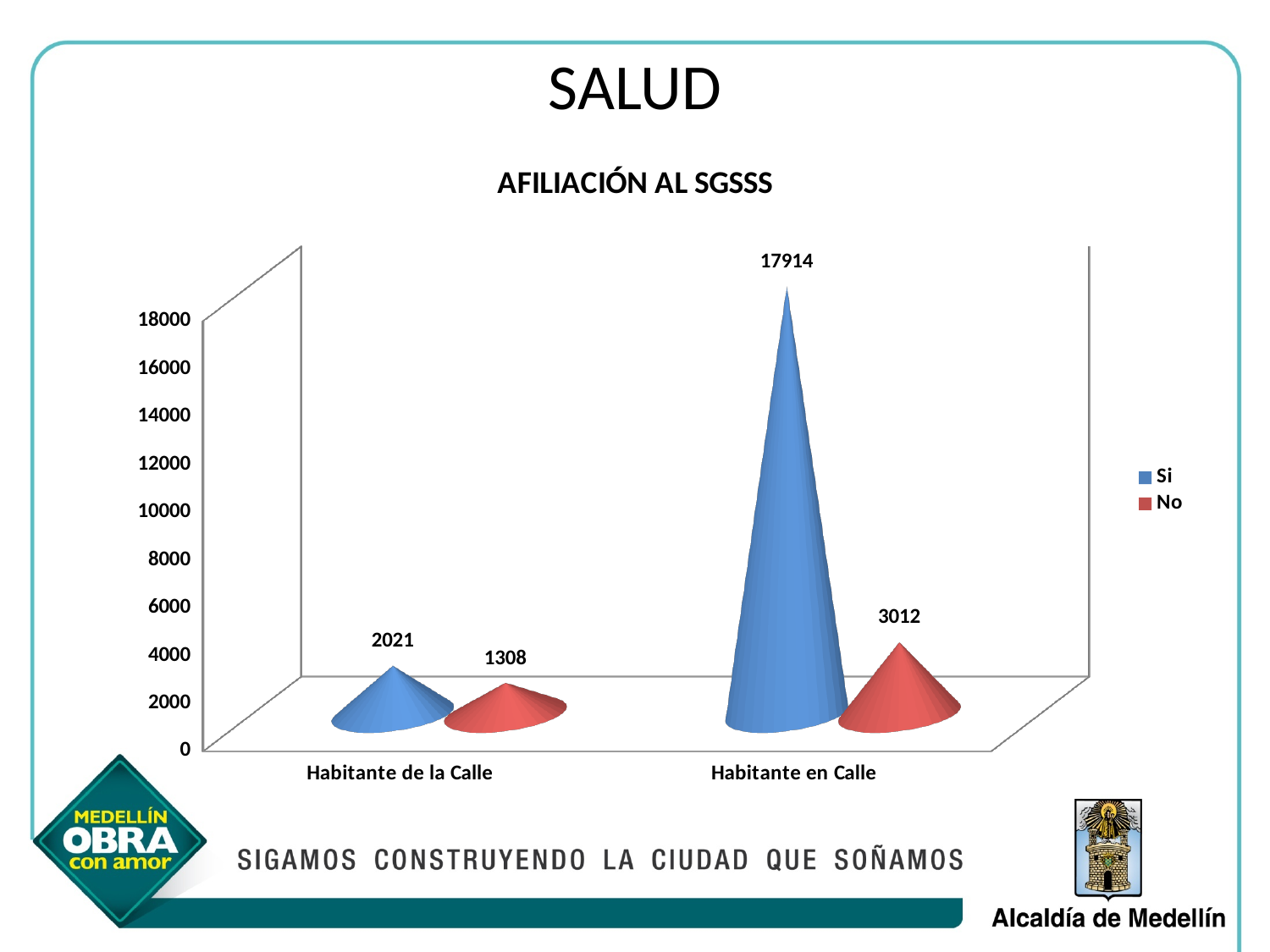
Which category has the highest 'Si' value? Habitante en Calle What is the value for 'No' for Habitante en Calle? 3012 How many series does the legend list? 2 What is the value for 'Si' for Habitante de la Calle? 2021 Which category has the lowest 'No' value? Habitante de la Calle What is the difference between the 'Si' and 'No' values for Habitante en Calle? 14902 What is the value for 'Si' for Habitante en Calle? 17914 What is the value for 'No' for Habitante de la Calle? 1308 What is the title of the chart? AFILIACIÓN AL SGSSS Which is larger for Habitante de la Calle, the 'Si' value or the 'No' value? Si What is the difference between the 'Si' and 'No' values for Habitante de la Calle? 713 How many categories are shown on the x axis? 2